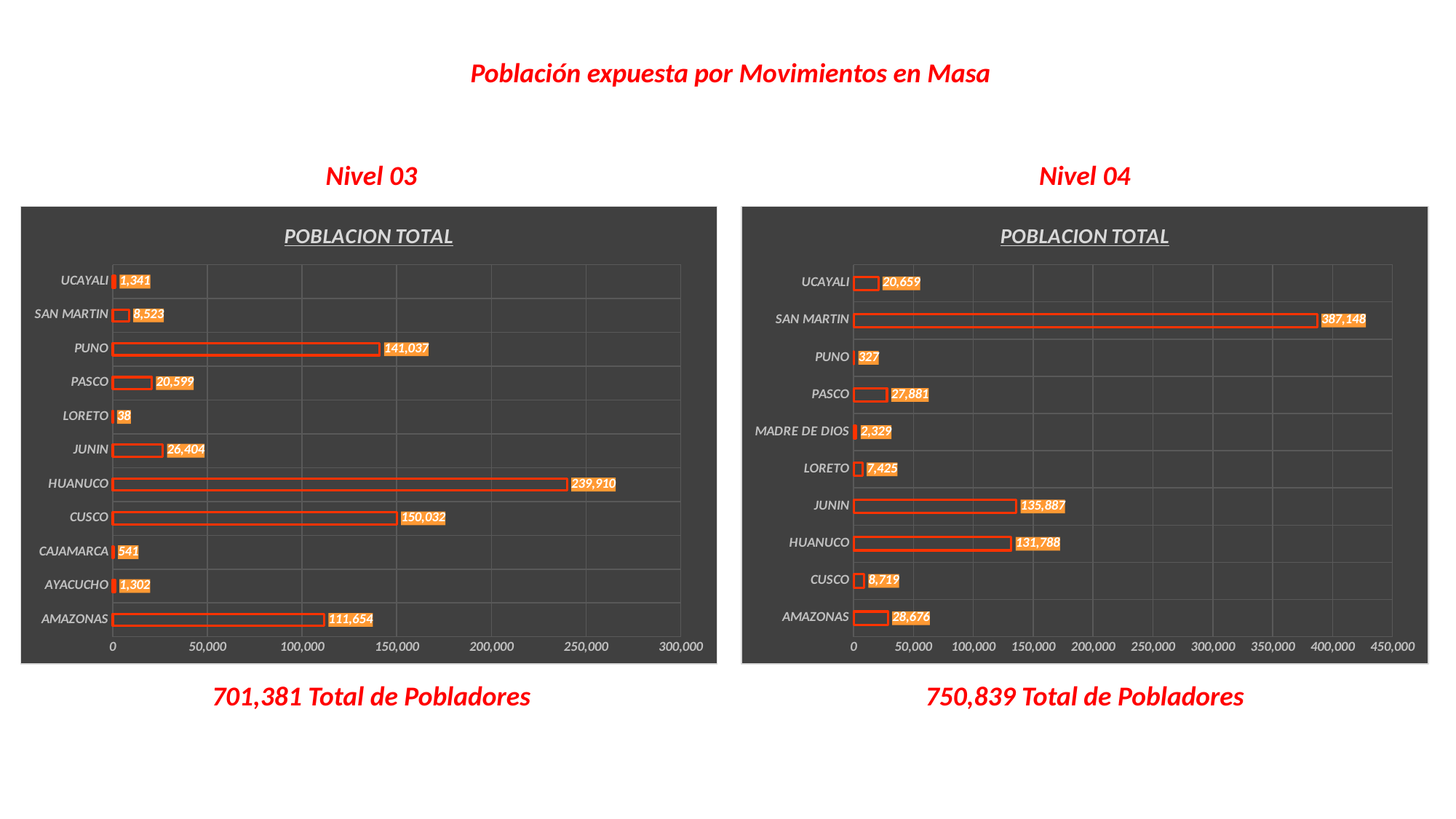
In the Nivel 04 chart (right), which category has the lowest value? PUNO In the Nivel 03 chart (left), is the value for AMAZONAS greater or less than 100,000? greater In the Nivel 03 chart (left), what is the difference between the values for HUANUCO and CUSCO? 89,878 How many categories are shown in the Nivel 04 chart (right)? 10 What kind of chart is the Nivel 03 chart (left)? Bar chart In the Nivel 03 chart (left), what is the value for PUNO? 141,037 In the Nivel 04 chart (right), what is the value for SAN MARTIN? 387,148 In the Nivel 03 chart (left), which category has the highest value? HUANUCO In the Nivel 03 chart (left), which category has the lowest value? LORETO In the Nivel 04 chart (right), what is the difference between the values for JUNIN and HUANUCO? 4,099 In the Nivel 04 chart (right), which is larger, the value for PASCO or the value for UCAYALI? PASCO How many categories are shown in the Nivel 03 chart (left)? 11